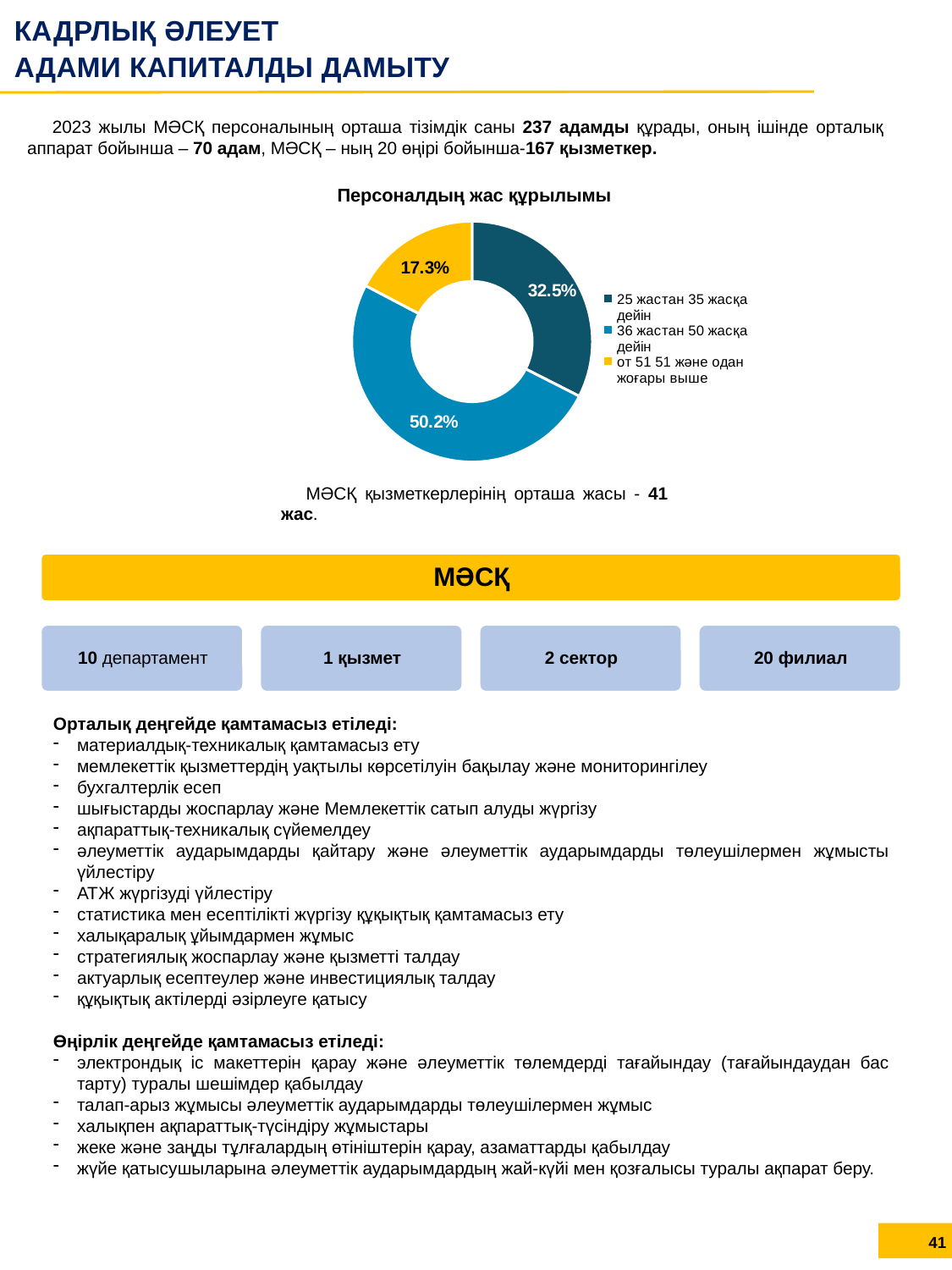
How many slices does the doughnut chart have? 3 What colour is the slice for the "36 жастан 50 жасқа дейін" group? Light blue What share of personnel is in the "25 жастан 35 жасқа дейін" age group? 32.5% What is the title of the chart on the slide? Персоналдың жас құрылымы What is the difference between the shares of the "36 жастан 50 жасқа дейін" and "25 жастан 35 жасқа дейін" groups? 17.7% What share of personnel is in the "от 51 51 және одан жоғары выше" age group? 17.3% What kind of chart is shown under the title "Персоналдың жас құрылымы"? Doughnut chart Which age group has the smallest share in the chart? от 51 51 және одан жоғары выше How many age groups does the chart legend list? 3 What share of personnel is in the "36 жастан 50 жасқа дейін" age group? 50.2% Which is larger: the share of the "25 жастан 35 жасқа дейін" group or the "от 51 51 және одан жоғары выше" group? 25 жастан 35 жасқа дейін Which age group has the largest share in the chart? 36 жастан 50 жасқа дейін